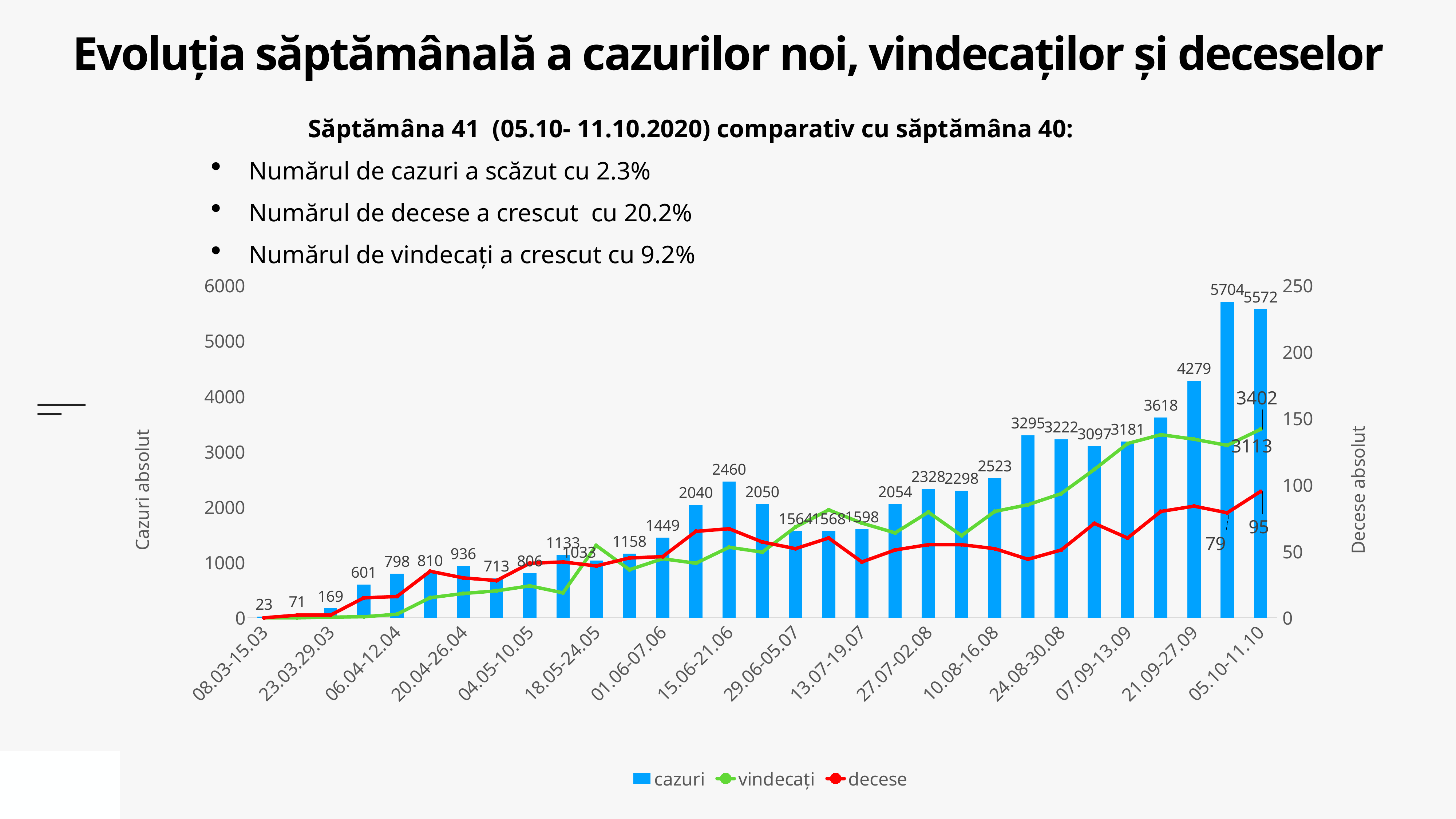
What is the cazuri value for the week 08.03-15.03? 23 What is the vindecați value for the week 05.10-11.10? 3402 What is the difference between the two decese values labelled on the chart, 95 and 79? 16 What is the cazuri value for the week 05.10-11.10? 5572 What is the cazuri value for the week 21.09-27.09? 4279 What is the decese value for the week 05.10-11.10? 95 What is the highest cazuri value shown on the chart? 5704 Which is larger, the cazuri value for 15.06-21.06 or for 29.06-05.07? 15.06-21.06 How many series does the legend list? 3 Which week has the lowest cazuri value? 08.03-15.03 What kind of chart is shown on the slide? Combined bar and line chart What is the difference between the vindecați values 3402 and 3113? 289